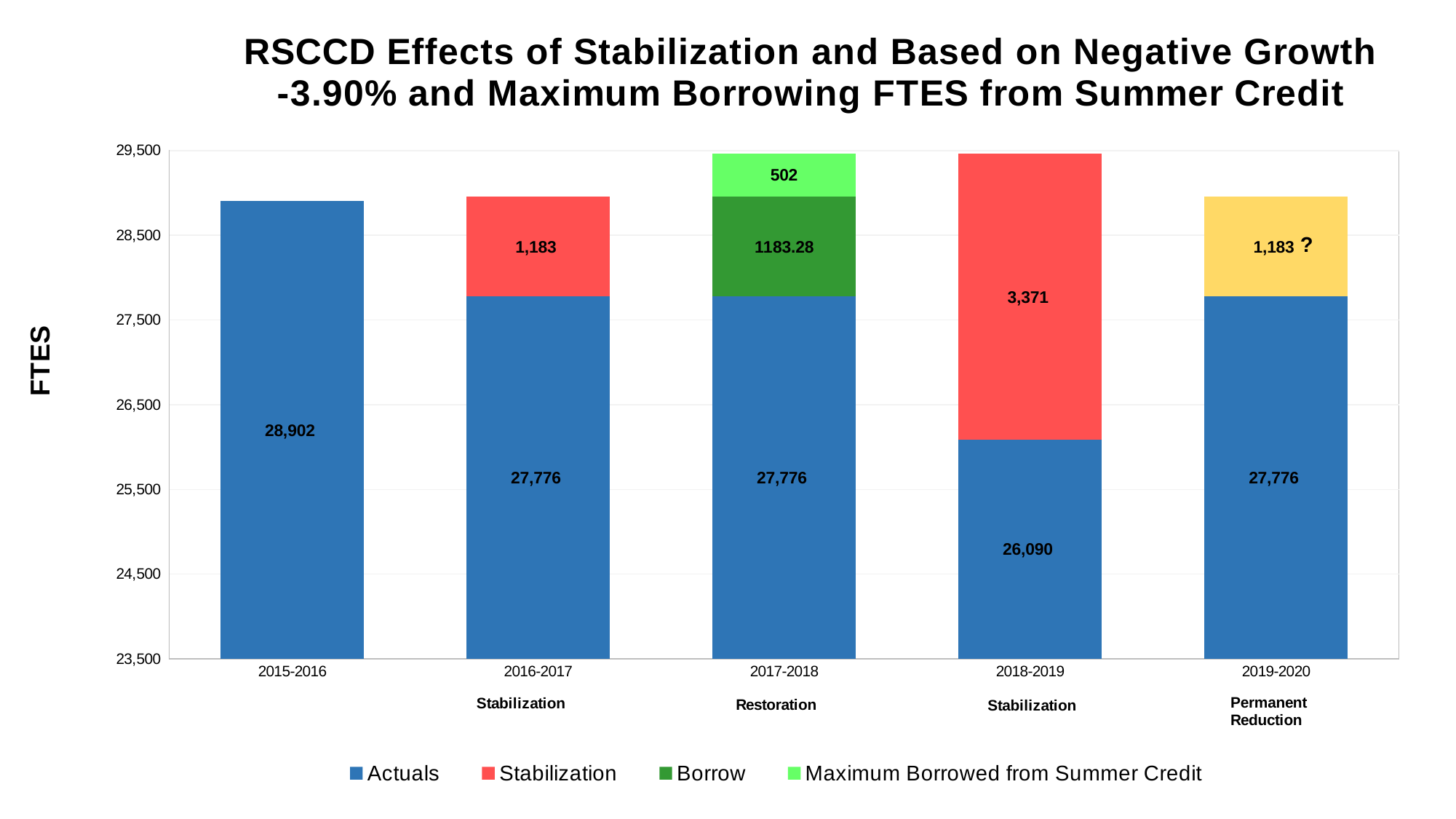
What is the Stabilization value for 2018-2019? 3,371 How many series does the legend list? 4 Which year has the highest Actuals value? 2015-2016 What is the Actuals value for 2015-2016? 28,902 Is the Stabilization value larger for 2016-2017 or 2018-2019? 2018-2019 What kind of chart is shown on the slide? Stacked bar chart What is the Maximum Borrowed from Summer Credit value for 2017-2018? 502 What is the Borrow value for 2017-2018? 1183.28 What is the total of the stacked bar for 2016-2017? 28,959 What is the difference between the Actuals for 2015-2016 and 2016-2017? 1,126 Which year has the lowest Actuals value? 2018-2019 Is the Actuals value for 2018-2019 greater or less than 26,500? less